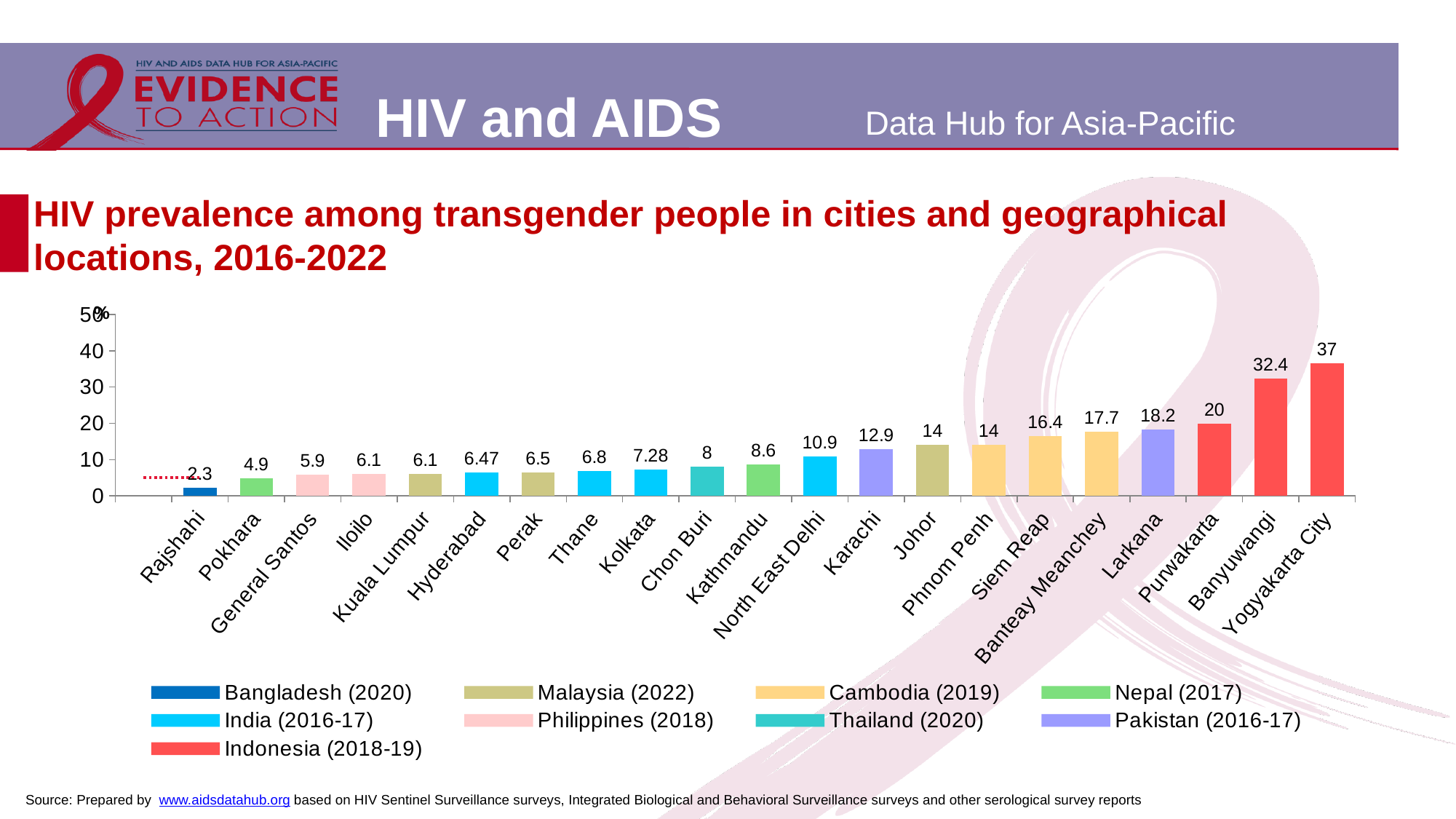
What type of chart is shown on the slide? Bar chart Which legend entry is shown in red? Indonesia (2018-19) What is the value shown for Banteay Meanchey? 17.7 What is the difference between the values for Yogyakarta City and Banyuwangi? 4.6 Is the value for Purwakarta greater or less than 10? greater Which city has the lowest HIV prevalence in the chart? Rajshahi How many cities or locations are plotted in the chart? 21 What is the value shown for Kolkata? 7.28 Which city has the highest HIV prevalence in the chart? Yogyakarta City Which has a higher value, Karachi or Larkana? Larkana How many countries does the legend list? 9 What is the HIV prevalence value shown for Yogyakarta City? 37